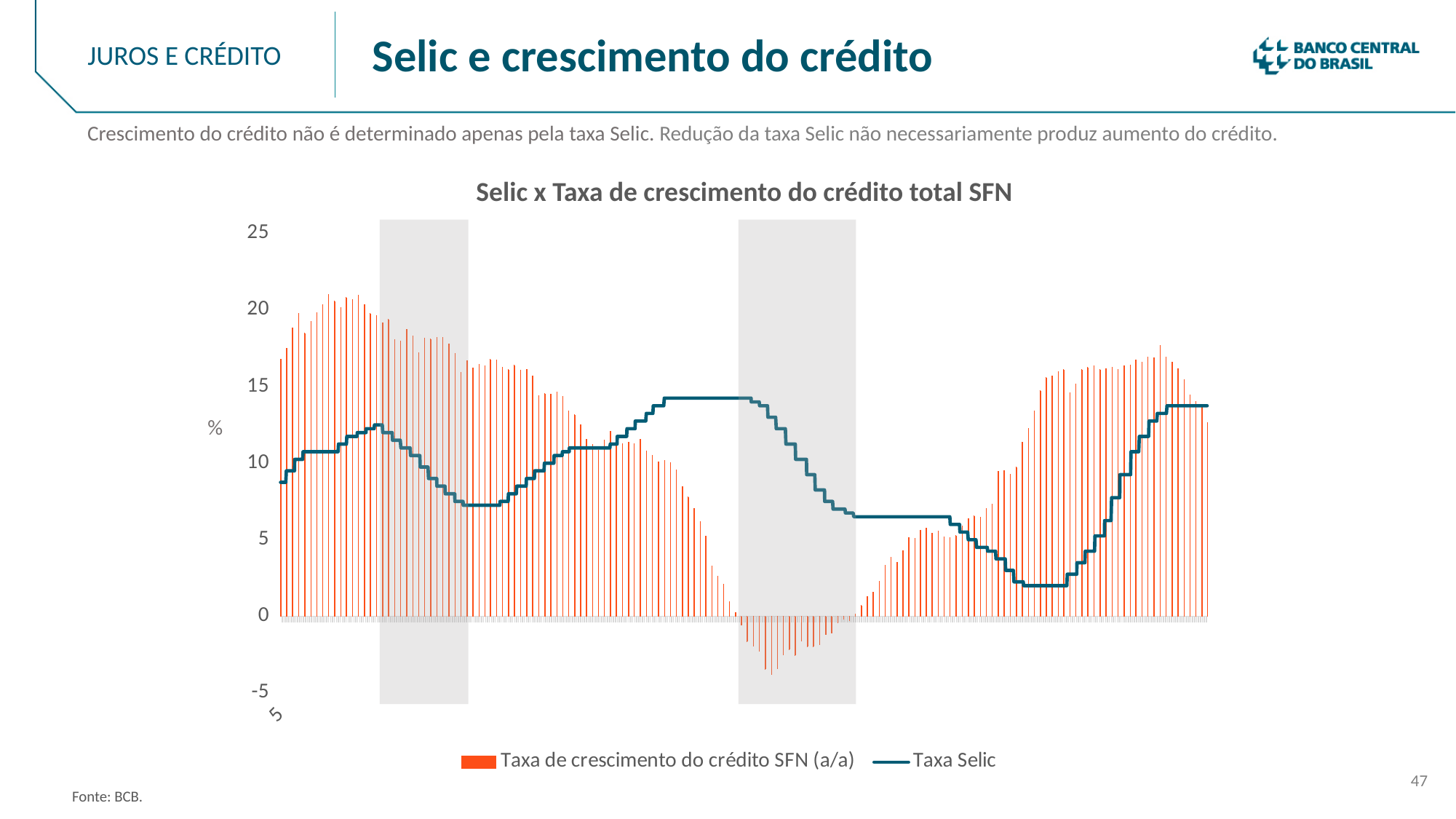
Which series is drawn in orange on the chart? Taxa de crescimento do crédito SFN (a/a) What is the highest value shown on the vertical axis of the chart? 25 Do the 'Taxa de crescimento do crédito SFN (a/a)' bars ever fall below 0 on the chart? Yes What is the lowest value shown on the vertical axis of the chart? -5 Is the lowest point of the 'Taxa Selic' line greater or less than 5? less What kind of chart is used to show the 'Taxa Selic' series? line chart What kind of chart is used to show the 'Taxa de crescimento do crédito SFN (a/a)' series? bar chart Is the highest plateau of the 'Taxa Selic' line greater or less than 15? less How many series does the chart legend list? 2